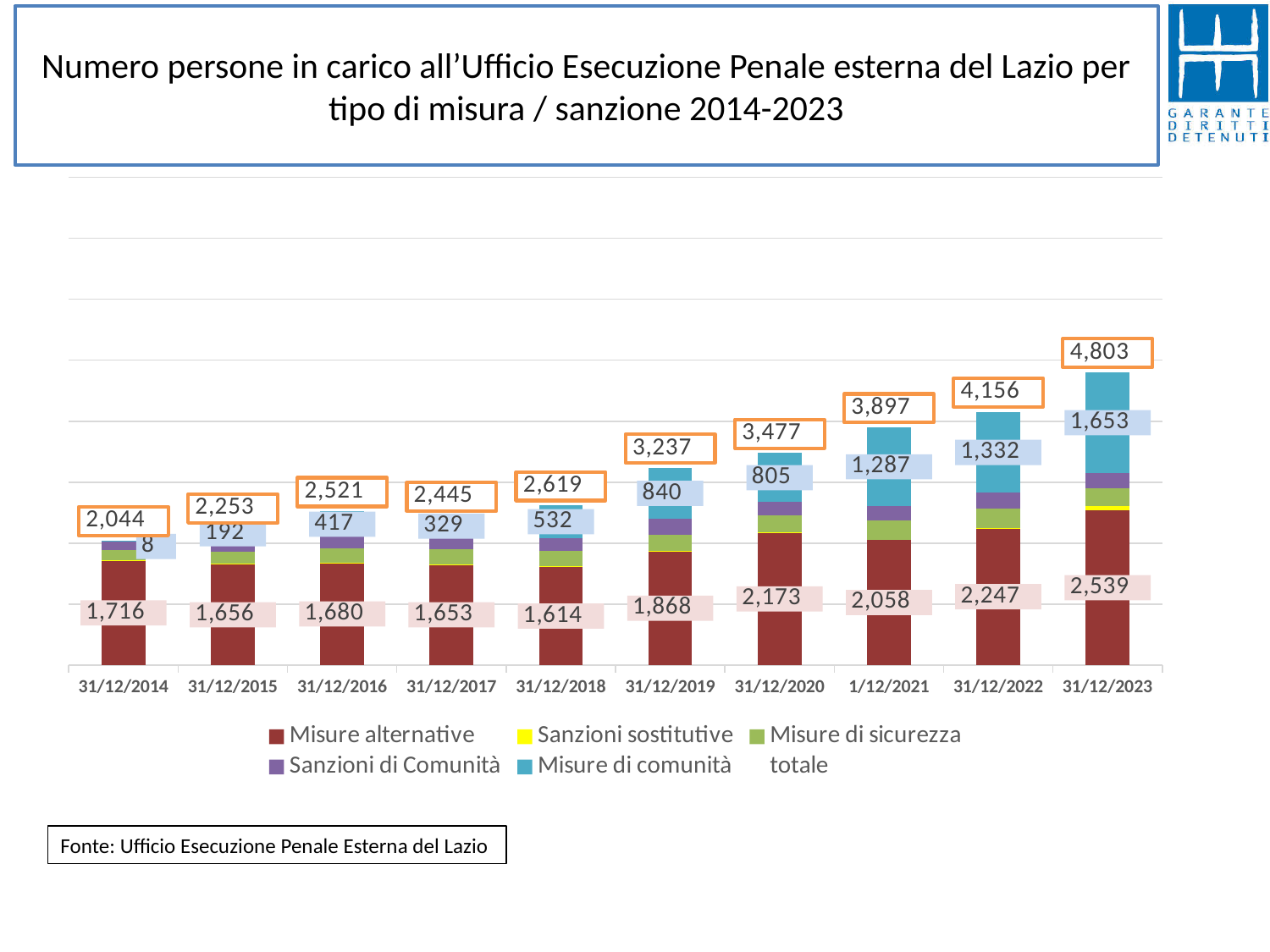
Does the totale value rise or fall from 31/12/2019 to 31/12/2023? Rise What is the value of Misure di comunità at 31/12/2019? 840 What is the value of Misure di comunità at 31/12/2014? 8 What is the totale value shown for 31/12/2016? 2,521 In which year is the totale value highest? 31/12/2023 What is the difference between the totale values for 31/12/2023 and 31/12/2022? 647 How many entries does the legend list? 6 How many dates are shown on the x axis? 10 What kind of chart is shown on the slide? Stacked bar chart In which year is the Misure alternative value lowest? 31/12/2018 Which is larger: Misure di comunità at 31/12/2019 or at 31/12/2020? 31/12/2019 What is the value of Misure alternative at 31/12/2023? 2,539